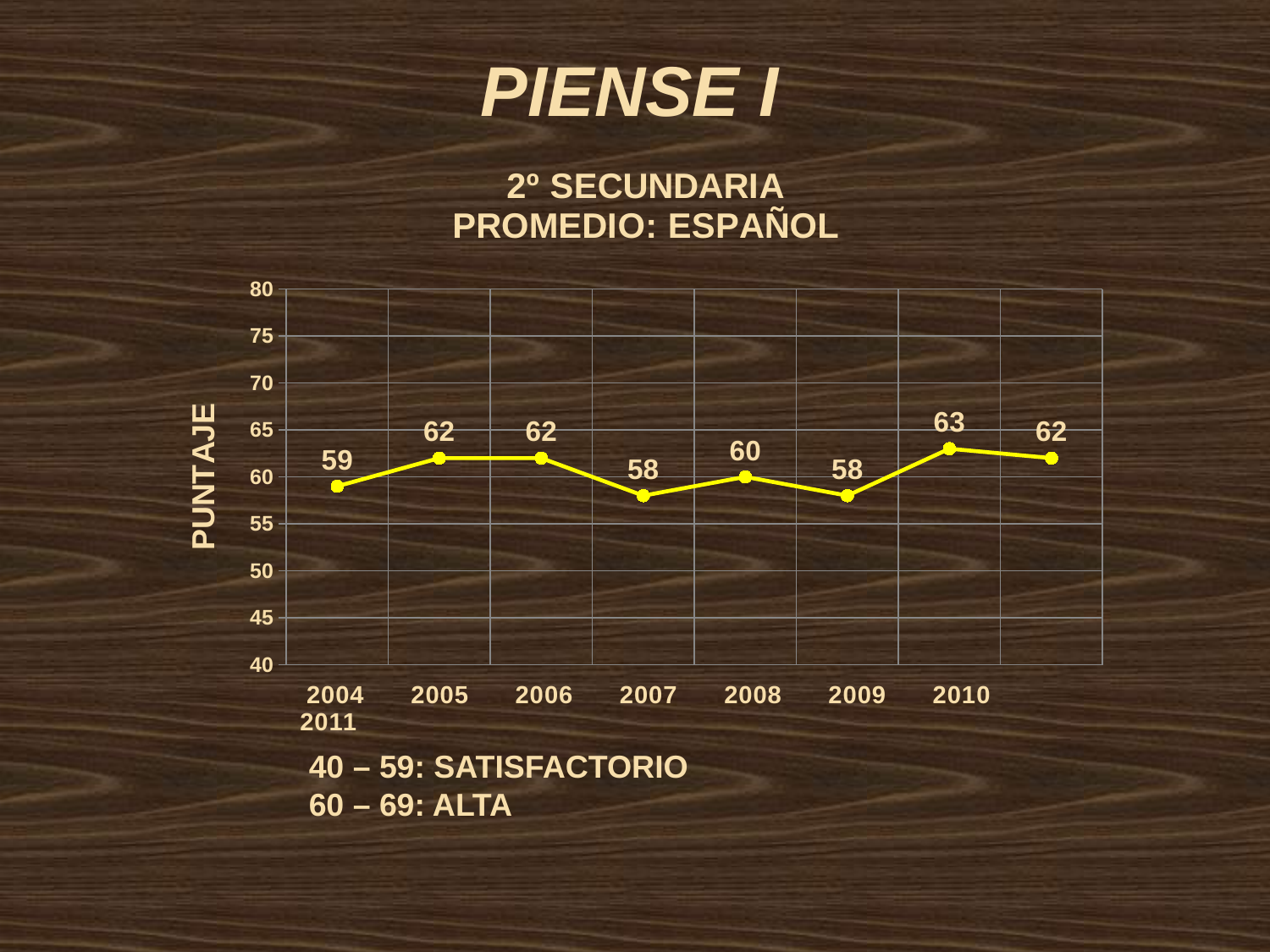
What is the difference between the PUNTAJE values for 2010 and 2009? 5 Which is larger, the PUNTAJE value for 2006 or for 2007? 2006 What is the difference between the PUNTAJE values for 2005 and 2004? 3 What is the PUNTAJE value for 2008? 60 What is the PUNTAJE value for 2007? 58 How many data points are plotted on the line? 8 Is the PUNTAJE value for 2009 greater or less than 60? less What is the PUNTAJE value for 2004? 59 What type of chart is shown on the slide? line chart What is the label on the vertical axis of the chart? PUNTAJE What is the PUNTAJE value for 2010? 63 Which year has the highest PUNTAJE value? 2010